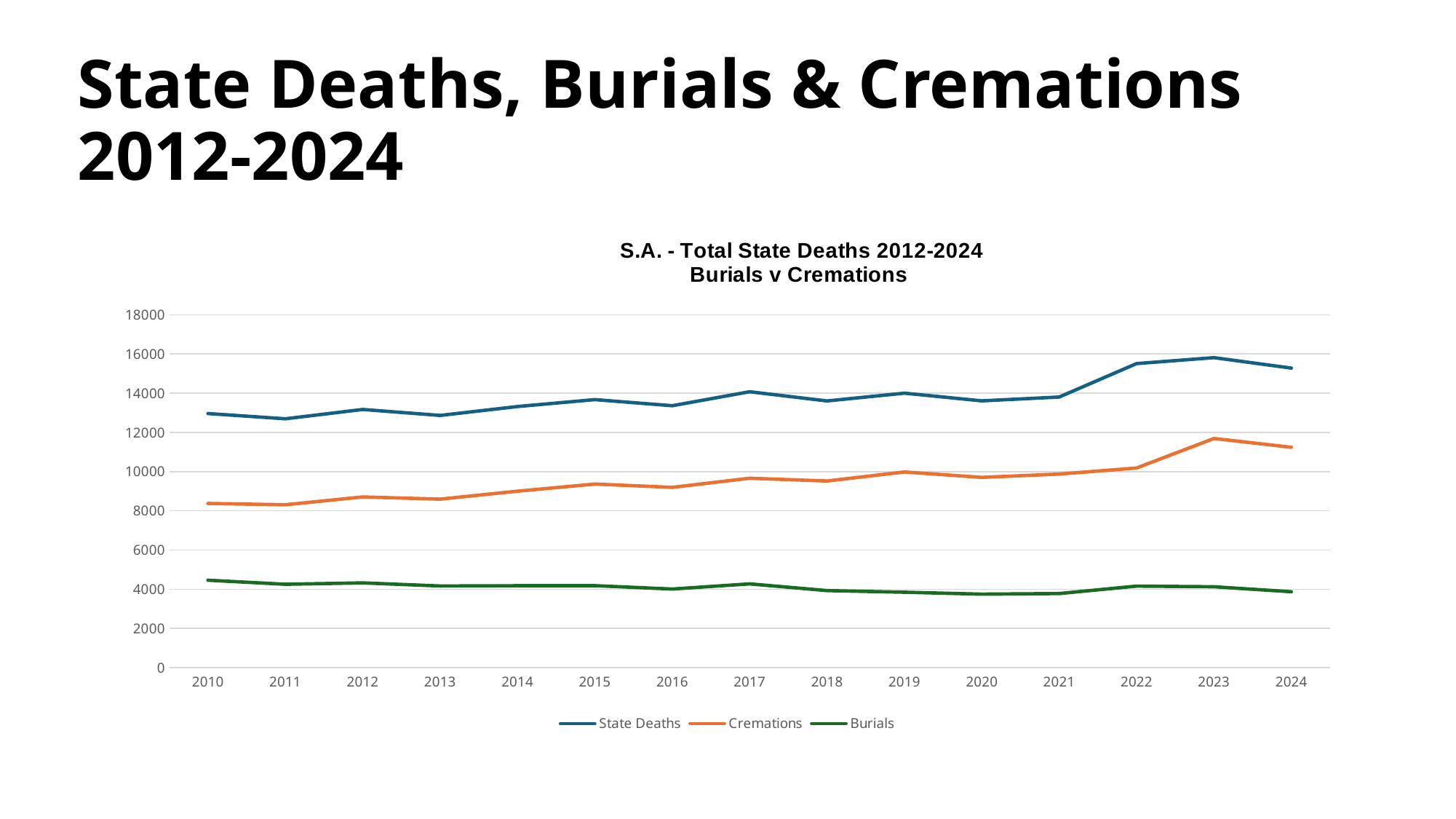
Is the value for Cremations in 2023 greater or less than 12000? less How many years are plotted along the x axis? 15 In 2024, which is larger: Cremations or Burials? Cremations Do the Cremations values generally rise or fall from 2010 to 2024? rise How many series does the legend list? 3 Is the value for Cremations in 2010 greater or less than 8000? greater In which year is the State Deaths line at its highest? 2023 Is the value for State Deaths in 2023 greater or less than 14000? greater In which year is the Cremations line at its highest? 2023 What colour is the Burials line in the legend? Green What kind of chart is shown on the slide? Line chart